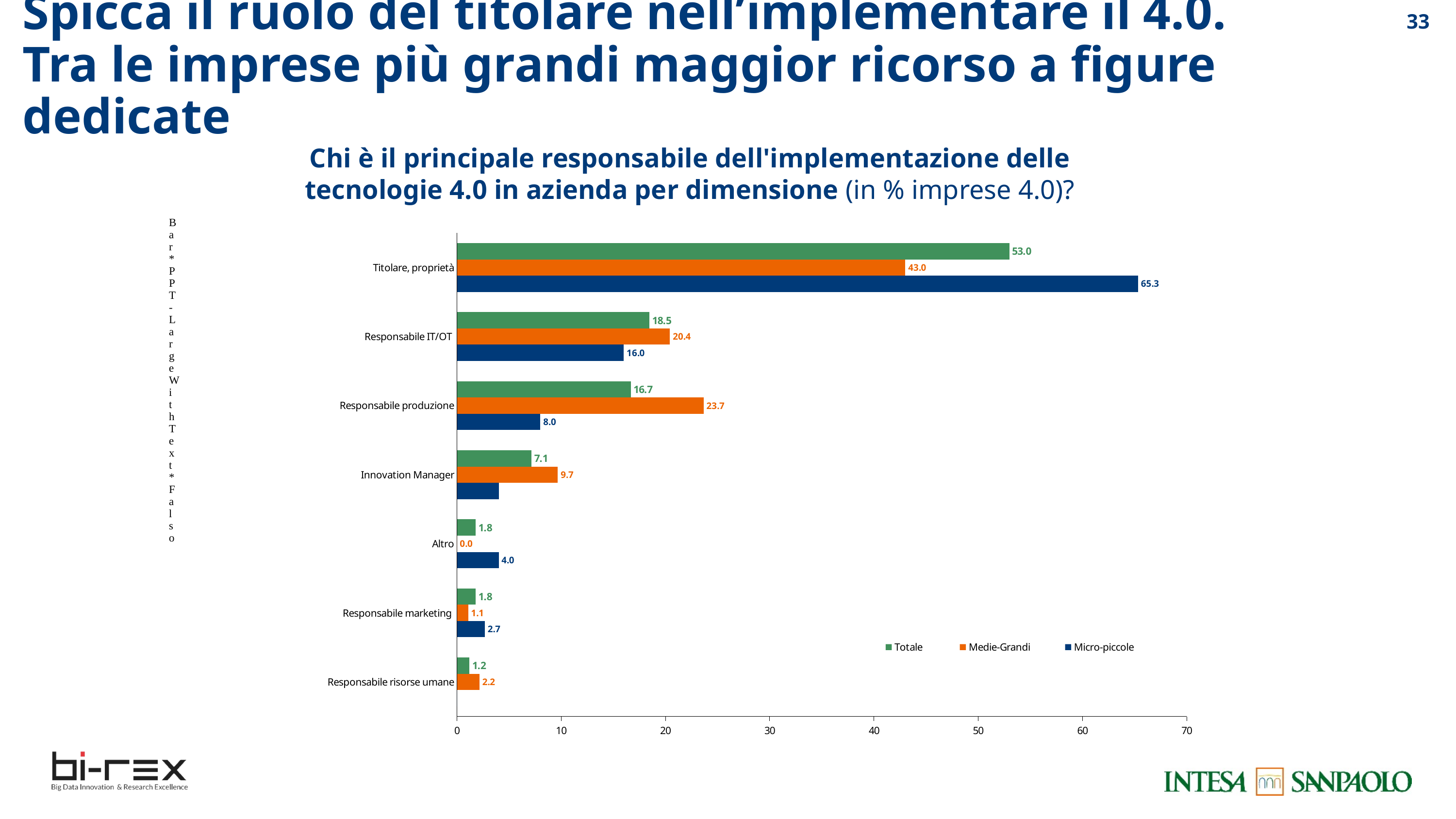
Which series is shown in orange in the legend? Medie-Grandi Which category has the highest Totale value? Titolare, proprietà What is the difference between the Micro-piccole and Medie-Grandi values for Titolare, proprietà? 22.3 How many series does the legend list? 3 For Responsabile produzione, which is larger: the Medie-Grandi value or the Micro-piccole value? Medie-Grandi What is the Medie-Grandi value for Responsabile produzione? 23.7 Which category has the lowest Medie-Grandi value? Altro What kind of chart is shown on the slide? bar chart How many categories are shown on the chart? 7 Is the Micro-piccole value for Innovation Manager greater or less than 10? less What is the Micro-piccole value for Titolare, proprietà? 65.3 What is the Totale value for Responsabile IT/OT? 18.5